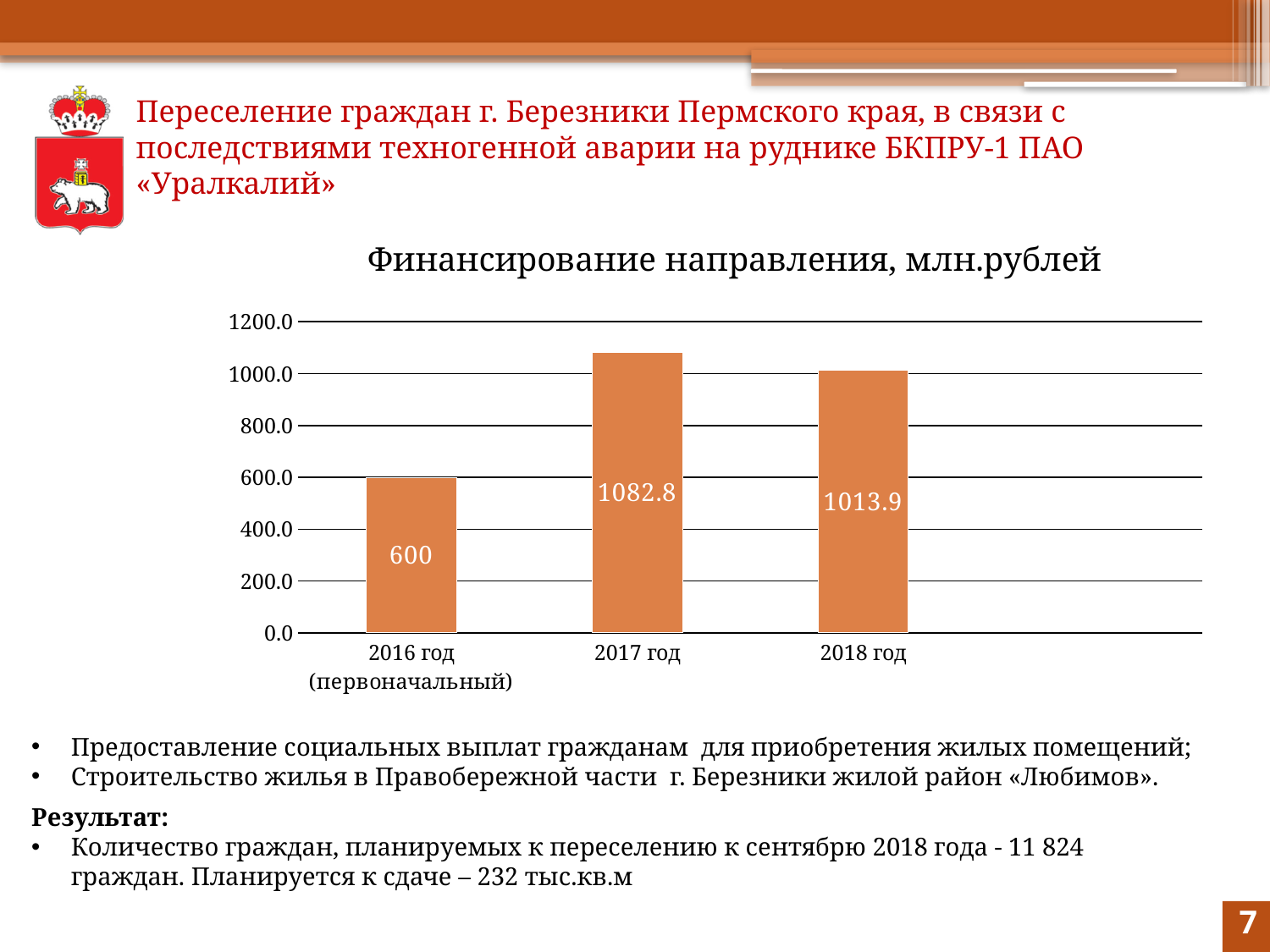
Which year has the lowest value? 2016 год (первоначальный) What is the title of the chart? Финансирование направления, млн.рублей What is the value for 2016 год (первоначальный)? 600 Which year has the highest value? 2017 год What kind of chart is shown on the slide? bar chart What is the value for 2018 год? 1013.9 Which is larger, the value for 2017 год or the value for 2018 год? 2017 год Is the value for 2018 год greater or less than 1000.0? greater What is the value for 2017 год? 1082.8 What is the difference between the values for 2017 год and 2016 год (первоначальный)? 482.8 How many categories are shown on the x axis? 3 What is the difference between the values for 2017 год and 2018 год? 68.9